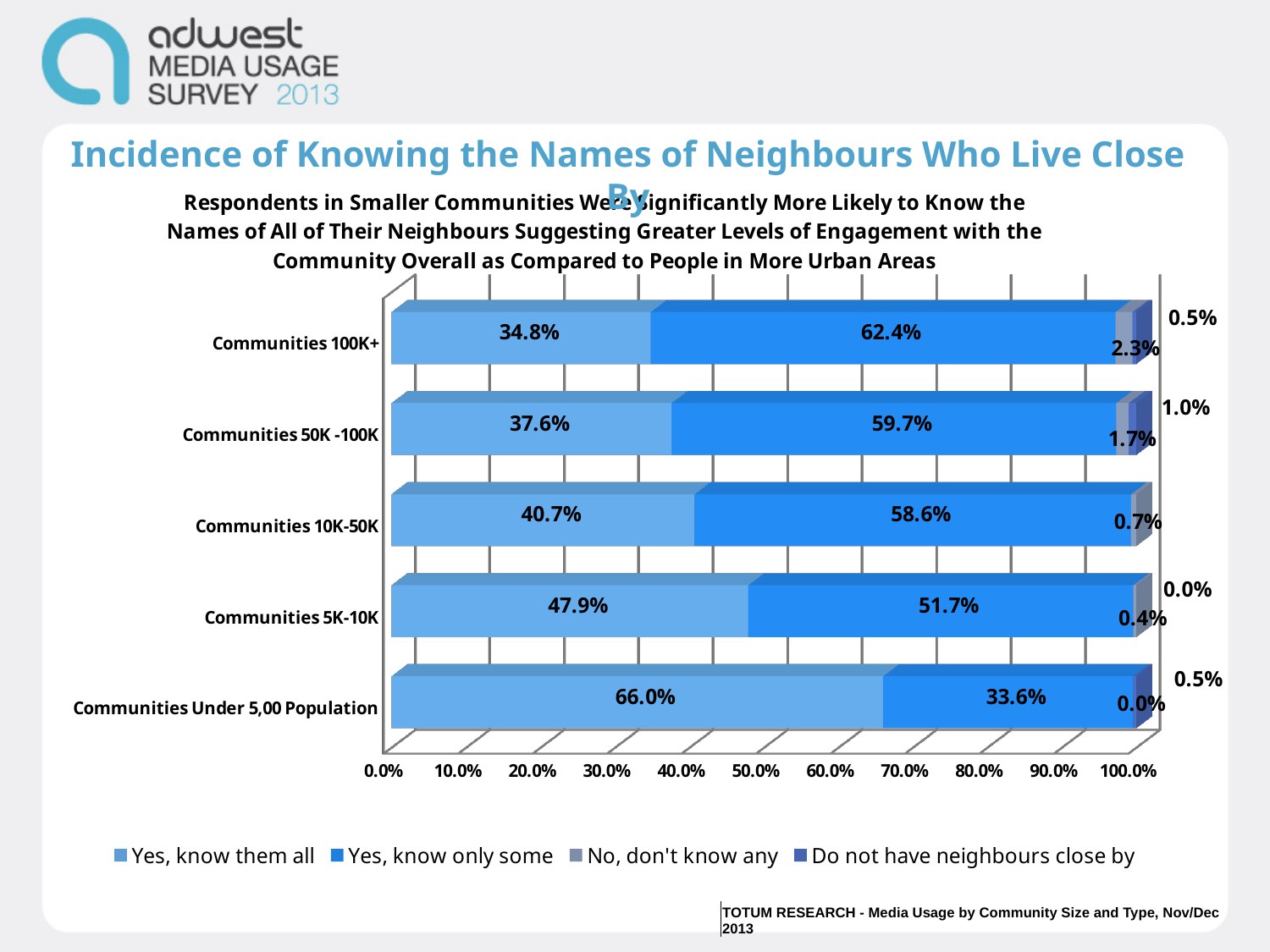
Which has a larger "Yes, know them all" percentage: Communities 10K-50K or Communities 50K -100K? Communities 10K-50K Does the "Yes, know them all" percentage rise or fall as the community size gets smaller? rises What percentage of respondents in Communities 5K-10K answered "Yes, know only some"? 51.7% What kind of chart is shown on the slide? Stacked bar chart What is the difference in the "Yes, know them all" percentage between Communities Under 5,00 Population and Communities 100K+? 31.2 percentage points Which community size has the highest "Yes, know them all" percentage? Communities Under 5,00 Population Is the "Yes, know them all" value for Communities 5K-10K greater or less than 50.0%? less What is the "Yes, know only some" value for Communities 50K -100K? 59.7% How many community size categories are shown in the chart? 5 Which community size has the lowest "Yes, know only some" percentage? Communities Under 5,00 Population What percentage of respondents in Communities 100K+ answered "Yes, know them all"? 34.8% How many series does the legend list? 4